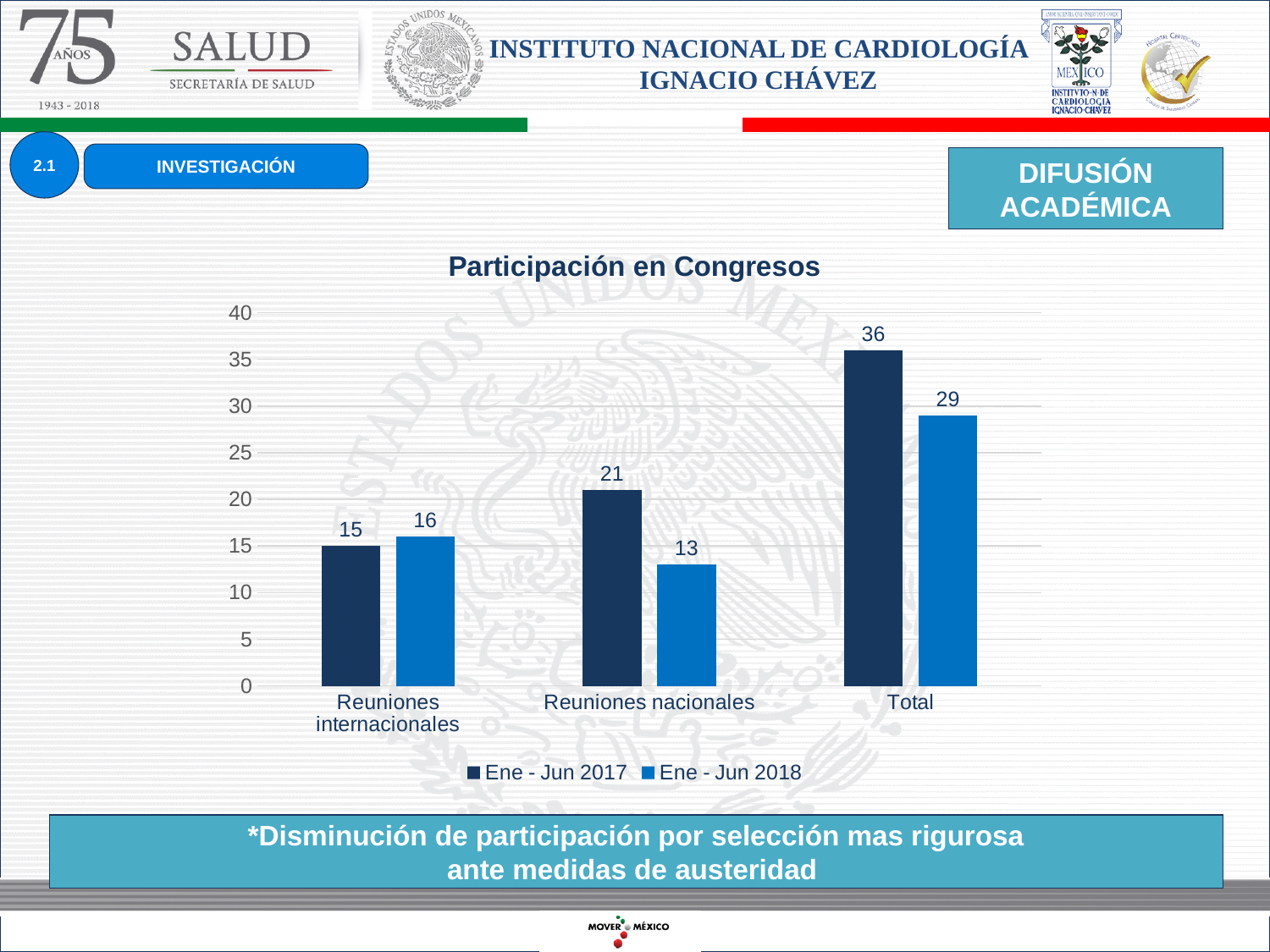
What is the difference between the Total values for Ene - Jun 2017 and Ene - Jun 2018? 7 What is the title of the chart? Participación en Congresos Which category has the highest value in the Ene - Jun 2018 series? Total For Reuniones nacionales, which series has the larger value, Ene - Jun 2017 or Ene - Jun 2018? Ene - Jun 2017 What kind of chart is shown on the slide? bar chart What is the value for Reuniones internacionales in the Ene - Jun 2017 series? 15 Which category has the lowest value in the Ene - Jun 2017 series? Reuniones internacionales What is the value for Reuniones nacionales in the Ene - Jun 2018 series? 13 How many categories are shown on the x axis? 3 What is the Total value for Ene - Jun 2017? 36 How many series does the legend list? 2 Is the Ene - Jun 2018 value for Total greater or less than 25? greater